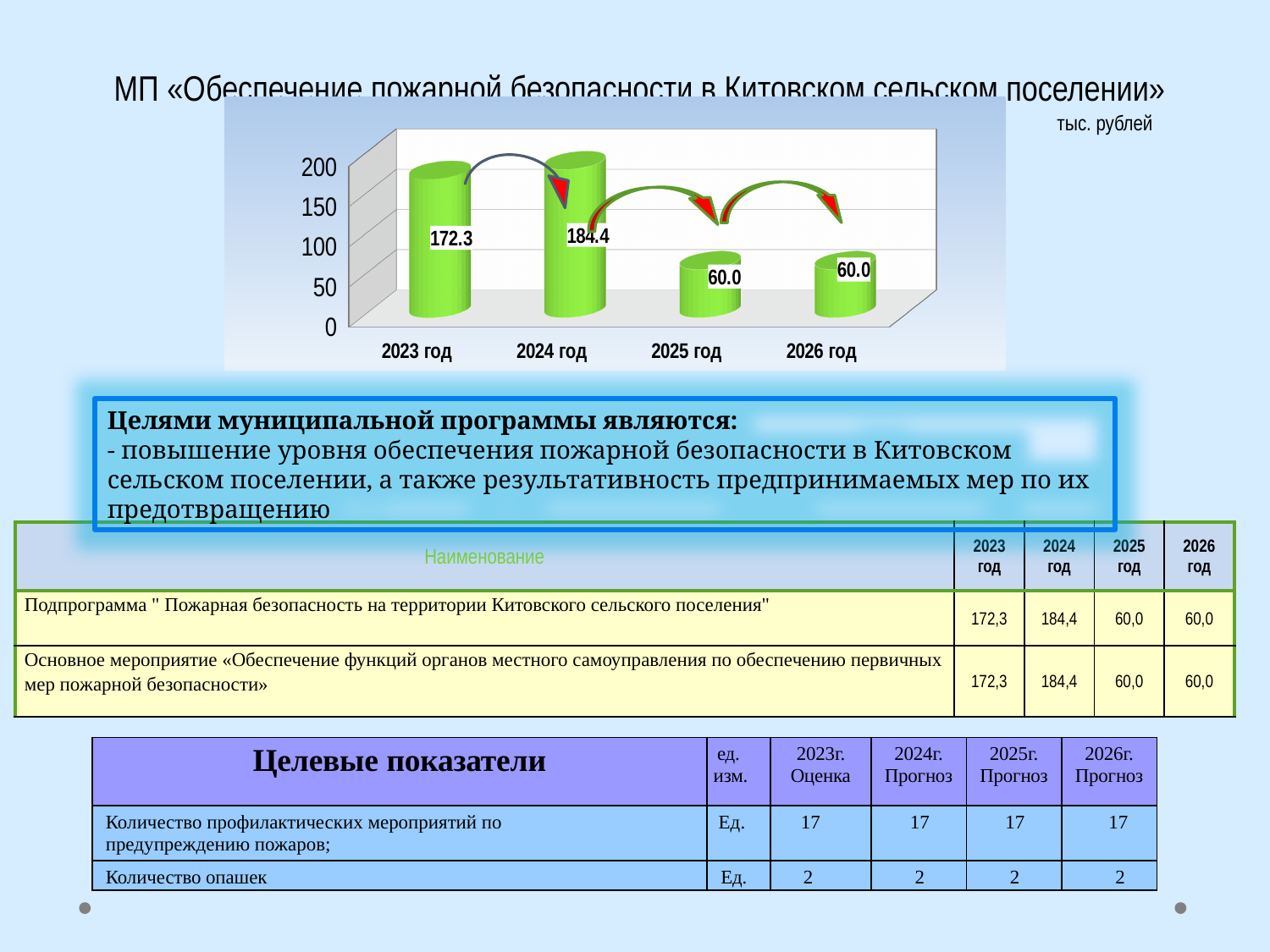
What kind of chart is shown on the slide? bar chart What unit of measurement is indicated for the chart values? тыс. рублей What is the value shown for 2023 год in the chart? 172.3 Which year has the highest value in the chart? 2024 год Which is larger in the chart, the value for 2023 год or the value for 2025 год? 2023 год What is the difference between the values for 2024 год and 2023 год in the chart? 12.1 How many years (categories) are shown in the chart? 4 What is the value shown for 2025 год in the chart? 60.0 What is the difference between the values for 2024 год and 2025 год in the chart? 124.4 Is the value for 2026 год in the chart greater or less than 100? less What is the value shown for 2024 год in the chart? 184.4 Is the value for 2023 год in the chart greater or less than 150? greater